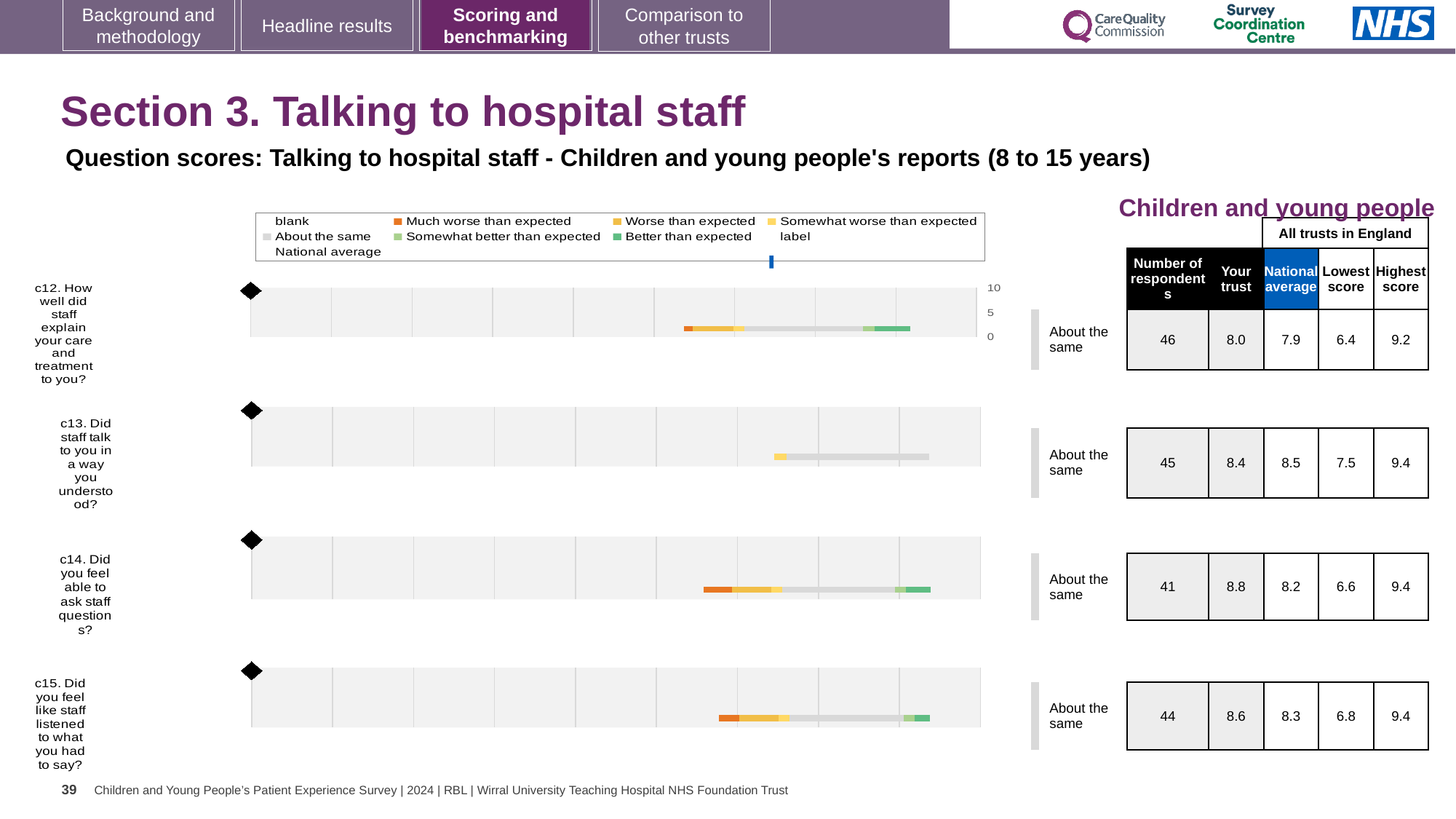
Which question has the highest 'Your trust' score? c14 For c14, what is the difference between the 'Your trust' score and the national average? 0.6 What benchmark category is shown for c12? About the same What is the 'Your trust' score for c12 (How well did staff explain your care and treatment to you?)? 8.0 Which question has the lowest 'Your trust' score? c12 For c13, which is larger: the 'Your trust' score or the national average? National average How many questions (chart rows) are shown on the slide? 4 What is the highest score among all trusts in England for c13? 9.4 What is the lowest score among all trusts in England for c12? 6.4 What kind of chart is used to show the benchmark results for questions c12 to c15? bar chart What is the national average score for c14 (Did you feel able to ask staff questions?)? 8.2 How many respondents answered c15 (Did you feel like staff listened to what you had to say?)? 44